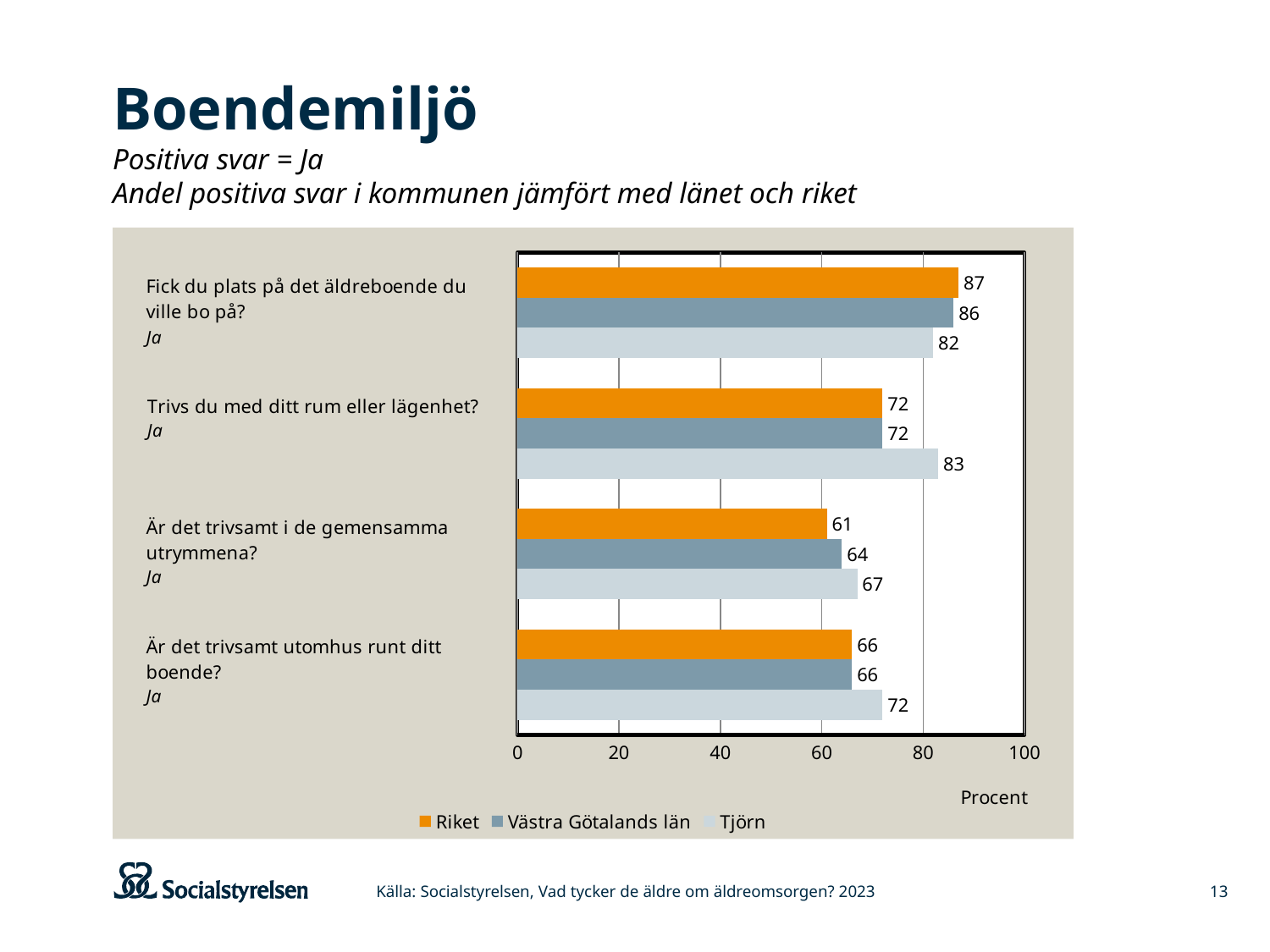
What label is shown on the x axis of the chart? Procent How many series does the legend list? 3 What is the value for Tjörn for "Är det trivsamt utomhus runt ditt boende?"? 72 What is the value for Riket for "Fick du plats på det äldreboende du ville bo på?"? 87 Which question has the highest value for Riket? Fick du plats på det äldreboende du ville bo på? How many question categories are shown on the chart? 4 Which question has the lowest value for Tjörn? Är det trivsamt i de gemensamma utrymmena? What type of chart is shown on the slide? bar chart For "Fick du plats på det äldreboende du ville bo på?", which is larger: the Riket value or the Tjörn value? Riket What is the value for Västra Götalands län for "Är det trivsamt i de gemensamma utrymmena?"? 64 What is the value for Tjörn for "Trivs du med ditt rum eller lägenhet?"? 83 What is the difference between the Tjörn value and the Riket value for "Trivs du med ditt rum eller lägenhet?"? 11